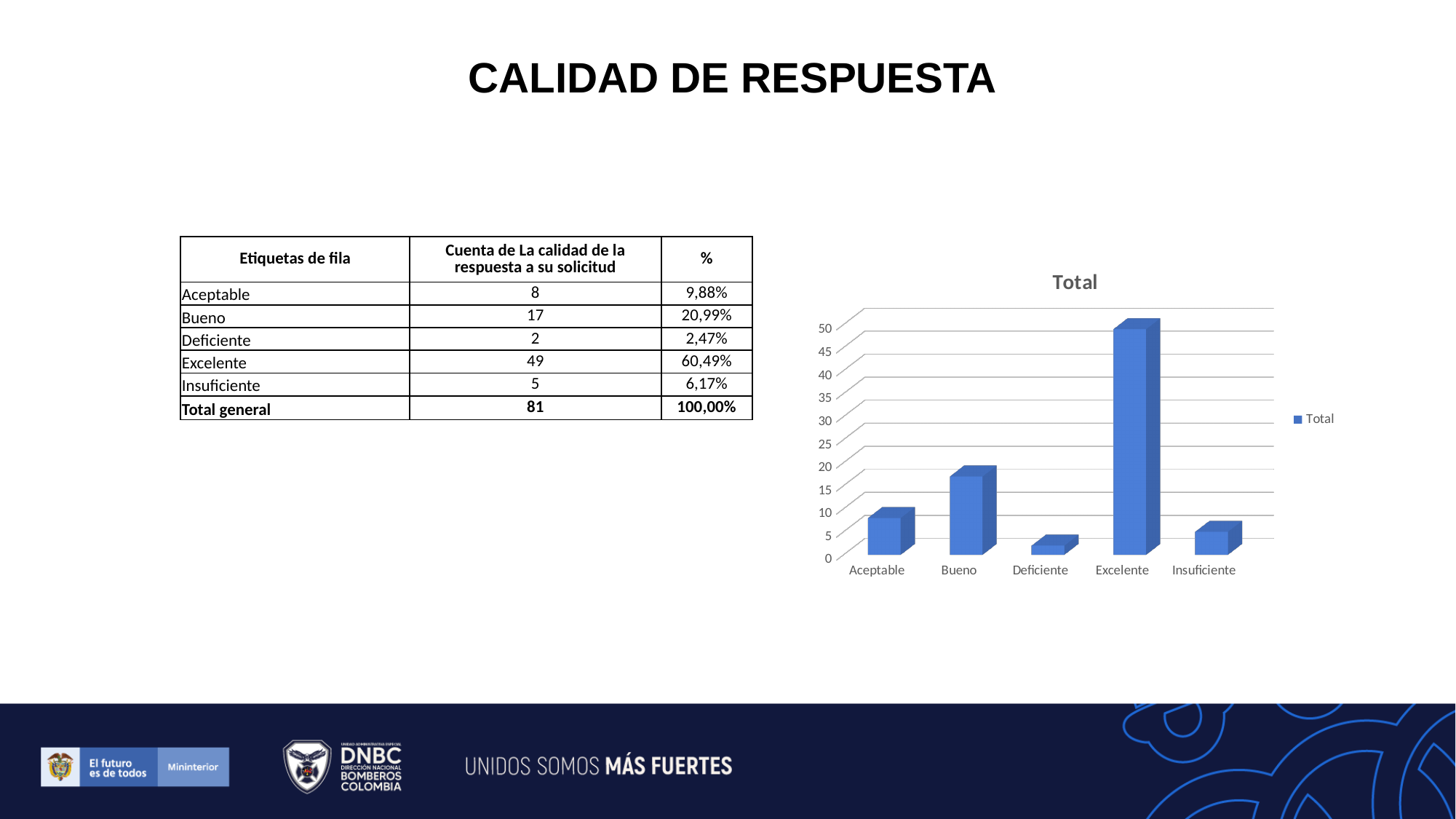
What is the title of the chart? Total Is the value for Deficiente greater or less than 5? less What kind of chart is shown on the slide? bar chart What is the difference between the values for Bueno and Aceptable? 9 Is the value for Bueno greater or less than 20? less Which category has the lowest bar in the chart? Deficiente Which category has the highest bar in the chart? Excelente How many categories are shown on the x axis of the chart? 5 What is the value for Excelente in the chart? 49 How many series does the chart legend list? 1 Which is larger, the value for Aceptable or the value for Insuficiente? Aceptable Is the value for Excelente greater or less than 45? greater